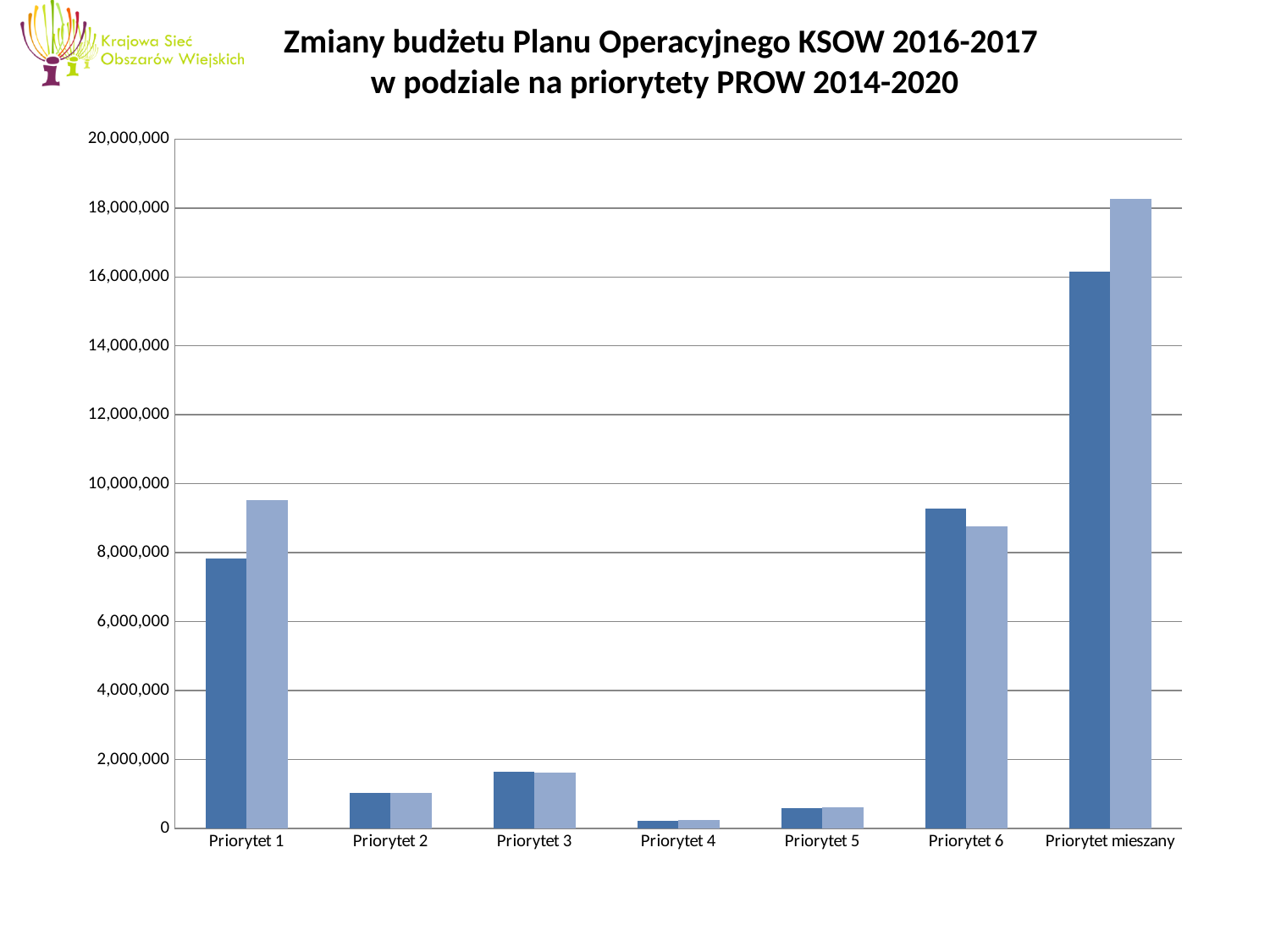
What kind of chart is shown on the slide? bar chart What is the title of the chart on the slide? Zmiany budżetu Planu Operacyjnego KSOW 2016-2017 w podziale na priorytety PROW 2014-2020 Is the value of the light blue bar for Priorytet mieszany greater or less than 18,000,000? greater Is the value of the dark blue bar for Priorytet 1 greater or less than 8,000,000? less Which category has the tallest bar in the chart? Priorytet mieszany For Priorytet 6, which bar is taller, the dark blue one or the light blue one? the dark blue one Which category has the lowest bars in the chart? Priorytet 4 For Priorytet 1, which bar is taller, the dark blue one or the light blue one? the light blue one Is the value of the light blue bar for Priorytet 3 greater or less than 2,000,000? less How many categories are shown on the x axis of the chart? 7 How many bars are plotted for each category in the chart? 2